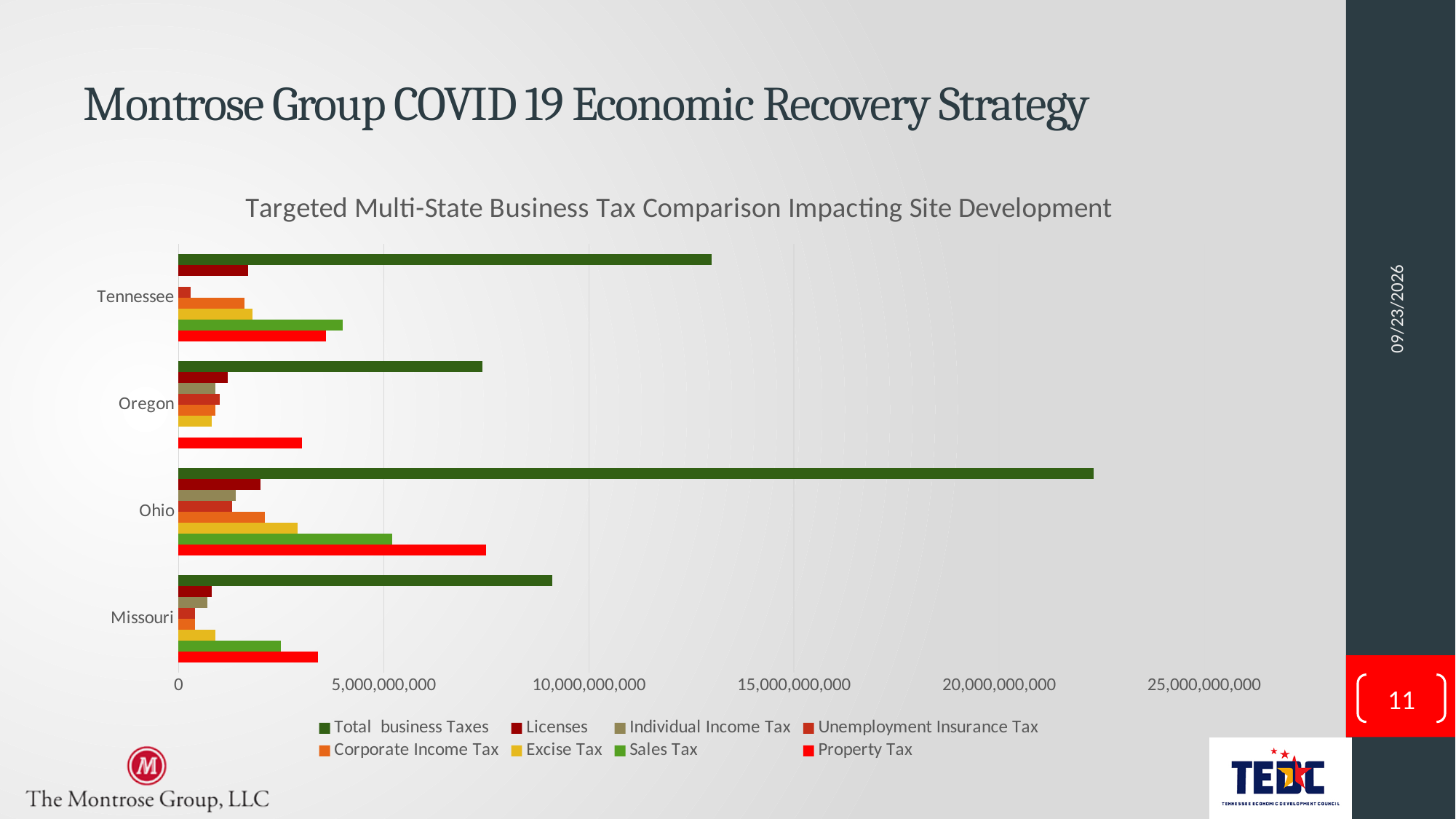
Is the Total business Taxes value for Tennessee greater or less than 15,000,000,000? less Is the Total business Taxes value for Ohio greater or less than 20,000,000,000? greater How many states are compared in the chart? 4 How many series does the chart legend list? 8 Which state has the higher Property Tax, Ohio or Tennessee? Ohio Is the Total business Taxes value for Missouri greater or less than 10,000,000,000? less Which state has the higher Sales Tax, Tennessee or Missouri? Tennessee Which state has the highest Total business Taxes? Ohio What is the title of the chart? Targeted Multi-State Business Tax Comparison Impacting Site Development Which state has the lowest Total business Taxes? Oregon What kind of chart is shown on the slide? Bar chart